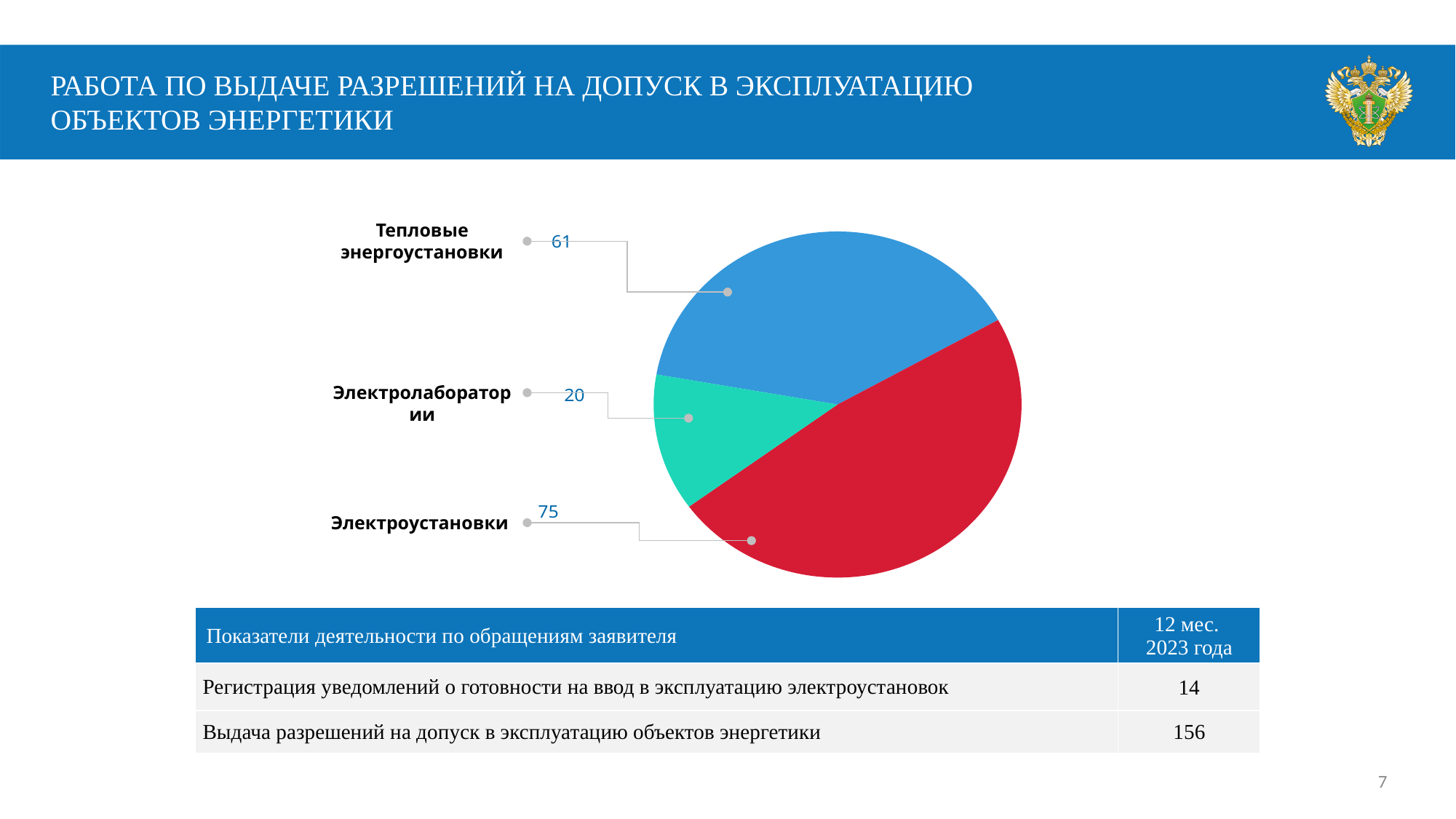
Which category has the smallest slice in the pie chart? Электролаборатории What is the difference between the values for Электроустановки and Тепловые энергоустановки? 14 What colour is the Электроустановки slice in the pie chart? red What is the value for Электролаборатории in the pie chart? 20 Which is larger: the value for Тепловые энергоустановки or the value for Электролаборатории? Тепловые энергоустановки What is the value for Электроустановки in the pie chart? 75 How many slices does the pie chart have? 3 What is the total of all three slices in the pie chart? 156 What is the difference between the values for Тепловые энергоустановки and Электролаборатории? 41 What type of chart is shown on the slide? pie chart What is the value for Тепловые энергоустановки in the pie chart? 61 Which category has the largest slice in the pie chart? Электроустановки